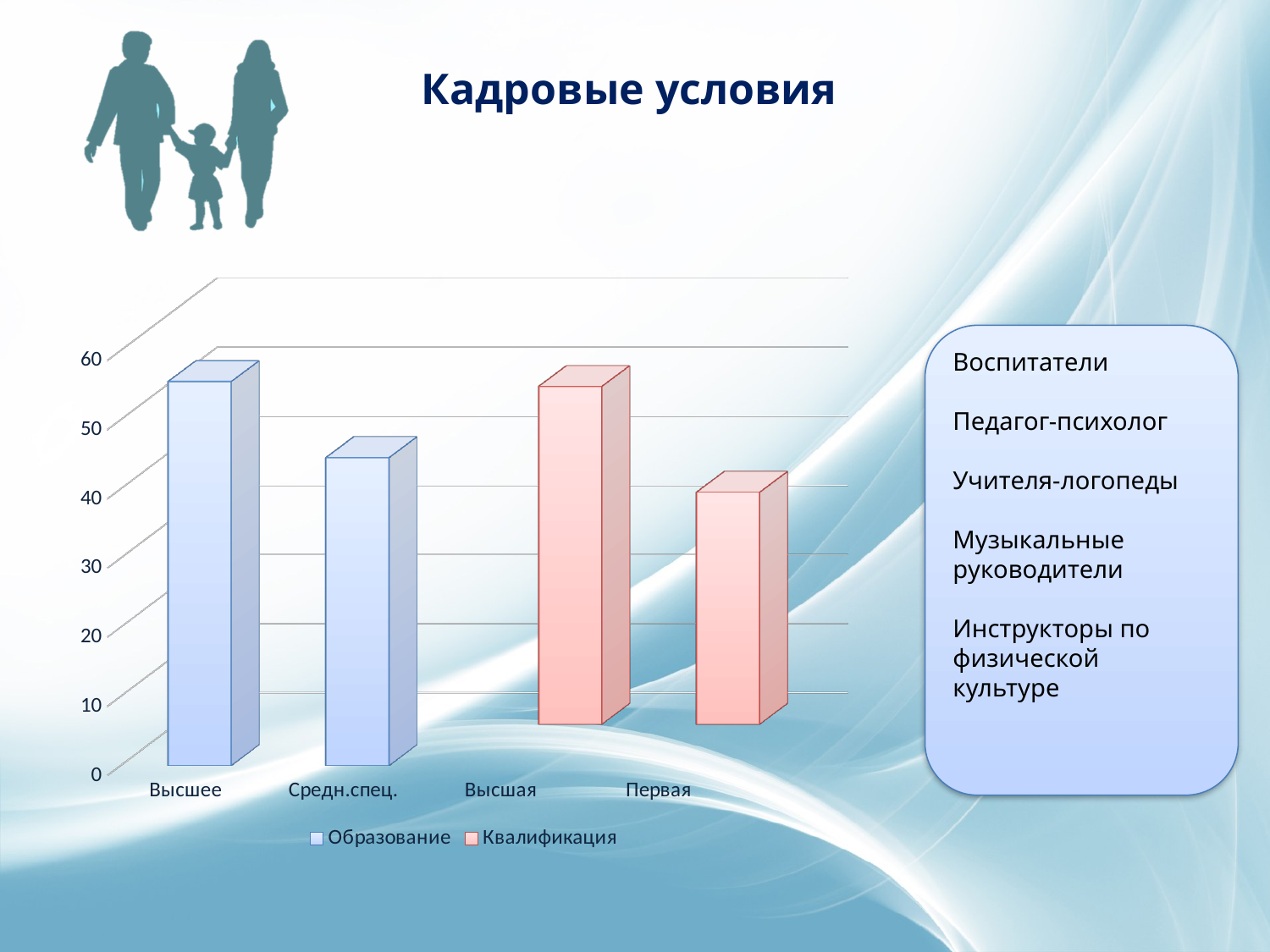
Which category has the lowest bar in the chart? Первая How many series does the chart legend list? 2 How many categories are shown on the x axis of the chart? 4 Which is larger, the value for Высшее or the value for Средн.спец.? Высшее Is the value for Первая greater or less than 50? less Is the value for Средн.спец. greater or less than 50? less What kind of chart is shown on the slide? bar chart Is the value for Средн.спец. greater or less than 40? greater What are the two series named in the chart legend? Образование, Квалификация Which is larger, the value for Высшая or the value for Первая? Высшая